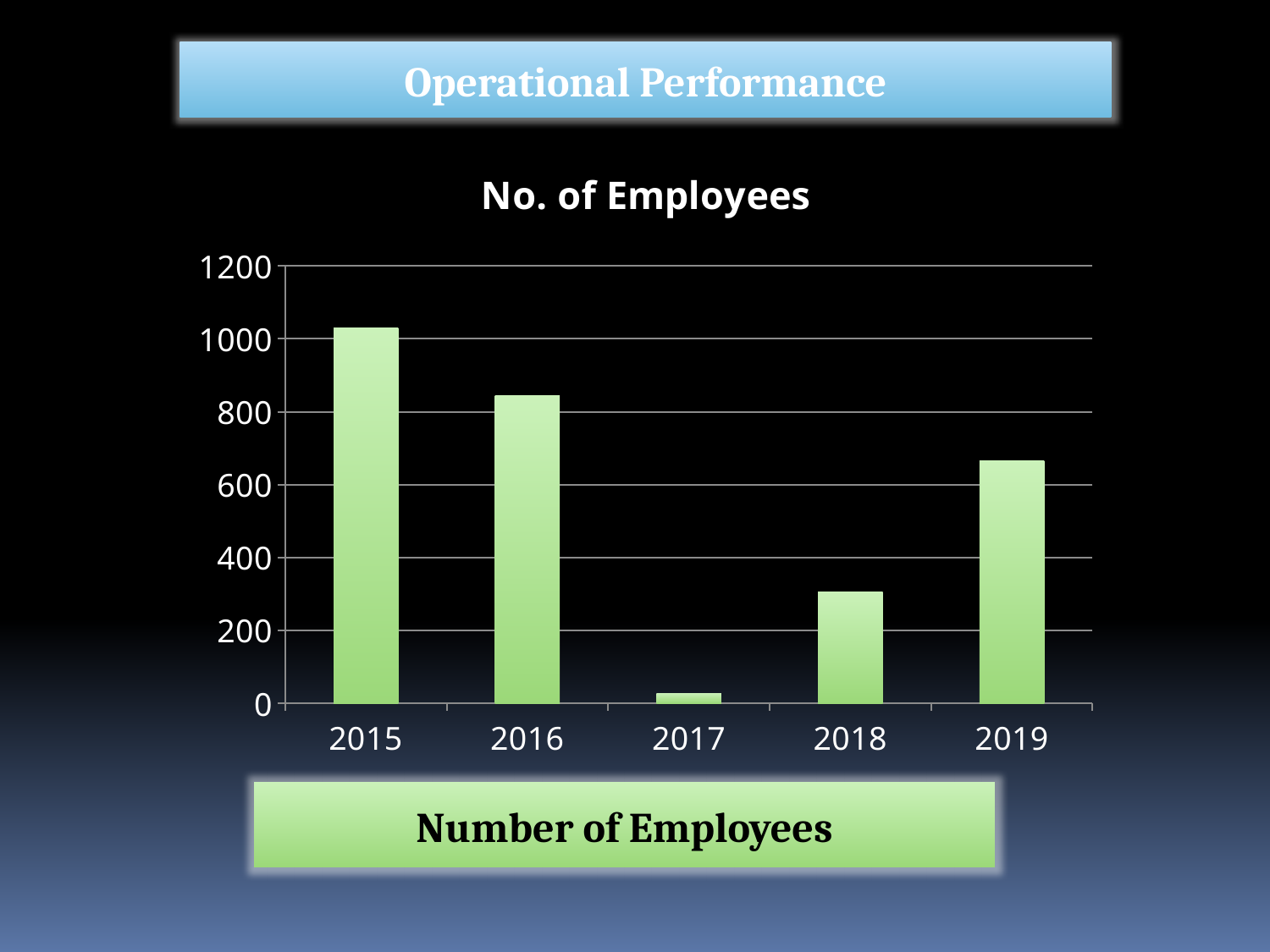
Which year has the lowest number of employees? 2017 Which year has more employees, 2018 or 2019? 2019 How many years are shown on the x axis of the chart? 5 Is the value for 2017 greater or less than 200? less From 2015 to 2017, do the values rise or fall? fall Is the value for 2018 greater or less than 400? less Which year has more employees, 2016 or 2019? 2016 Is the value for 2019 greater or less than 600? greater What kind of chart is shown on the slide? bar chart What is the title of the chart? No. of Employees Which year has the highest number of employees? 2015